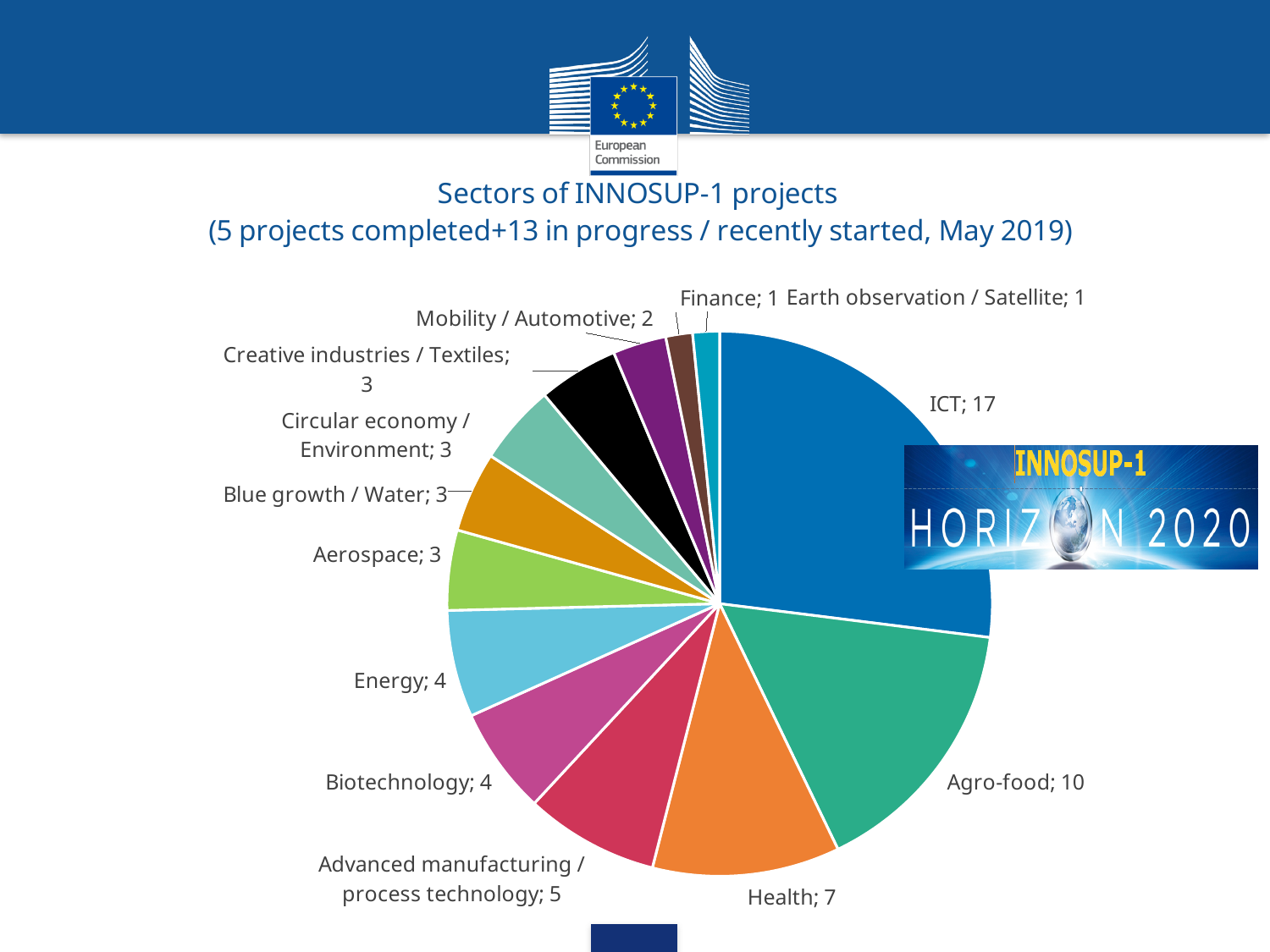
How many projects are in the ICT sector? 17 How many sectors are shown in the pie chart? 13 What is the difference between the number of Health projects and Biotechnology projects? 3 How many projects are in the Agro-food sector? 10 What is the title of the chart? Sectors of INNOSUP-1 projects (5 projects completed+13 in progress / recently started, May 2019) How many projects are in the Health sector? 7 What is the difference between the number of ICT projects and Agro-food projects? 7 Which sector has the largest number of projects? ICT How many projects are in the Mobility / Automotive sector? 2 What kind of chart is shown on the slide? pie chart How many projects are in the Advanced manufacturing / process technology sector? 5 Which sector has more projects, Energy or Aerospace? Energy